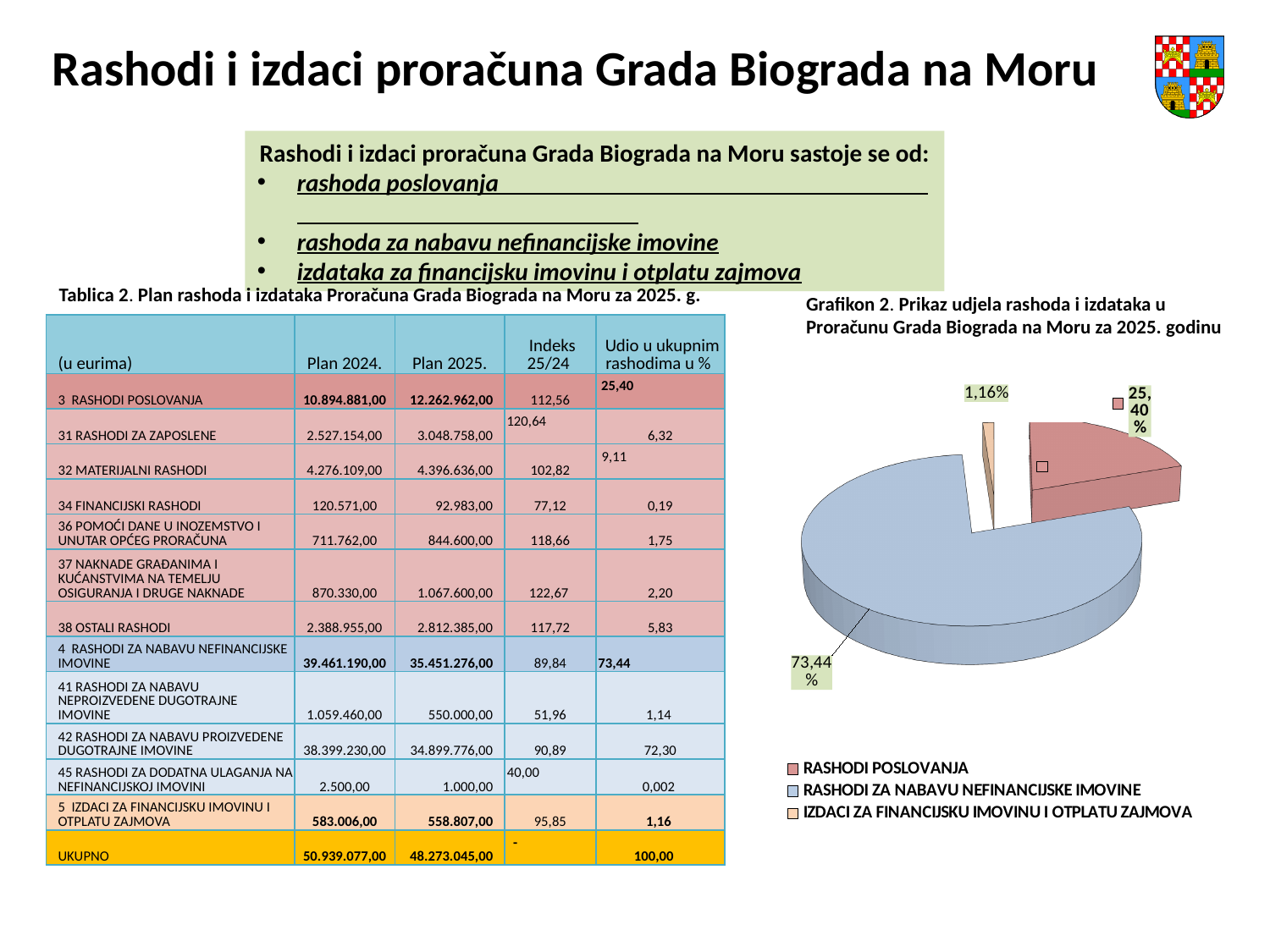
What is the difference in percentage points between the RASHODI ZA NABAVU NEFINANCIJSKE IMOVINE slice and the RASHODI POSLOVANJA slice? 48,04 What is the share of IZDACI ZA FINANCIJSKU IMOVINU I OTPLATU ZAJMOVA in the pie chart? 1,16% What is the title of the pie chart? Grafikon 2. Prikaz udjela rashoda i izdataka u Proračunu Grada Biograda na Moru za 2025. godinu How many slices does the pie chart have? 3 What is the share of RASHODI ZA NABAVU NEFINANCIJSKE IMOVINE in the pie chart? 73,44% Which category has the smallest slice in the pie chart? IZDACI ZA FINANCIJSKU IMOVINU I OTPLATU ZAJMOVA Which category has the largest slice in the pie chart? RASHODI ZA NABAVU NEFINANCIJSKE IMOVINE How many entries does the legend of the pie chart list? 3 Which legend entry is shown in red/pink in the pie chart? RASHODI POSLOVANJA What is the share of RASHODI POSLOVANJA in the pie chart? 25,40% Which is larger in the pie chart: RASHODI POSLOVANJA or IZDACI ZA FINANCIJSKU IMOVINU I OTPLATU ZAJMOVA? RASHODI POSLOVANJA What kind of chart is shown on the slide? pie chart